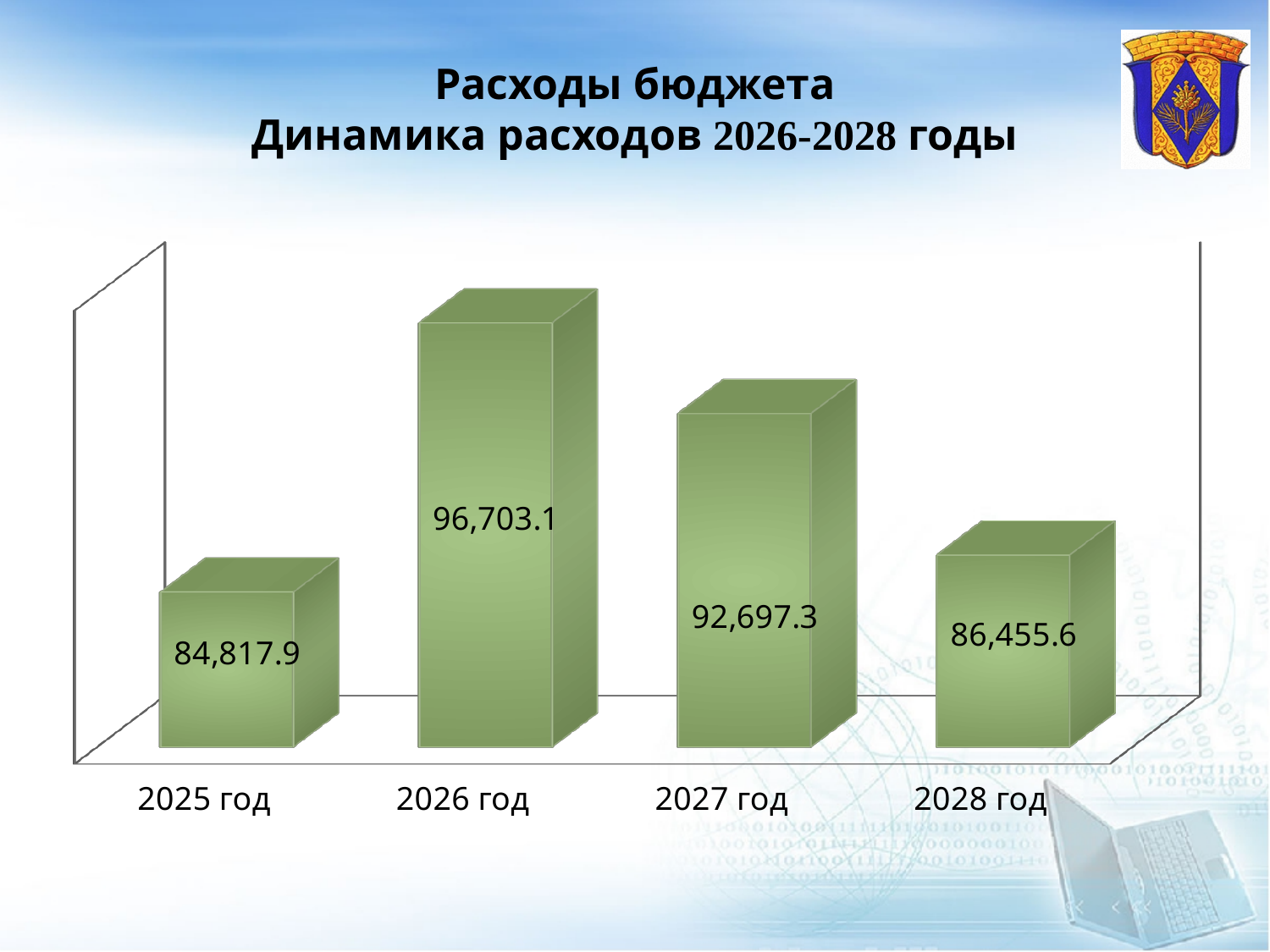
Which is larger, the value for 2027 год or the value for 2028 год? 2027 год What is the value shown for 2026 год? 96,703.1 Which year has the lowest value? 2025 год What is the value shown for 2027 год? 92,697.3 What is the value shown for 2028 год? 86,455.6 What is the difference between the values for 2026 год and 2025 год? 11,885.2 From 2026 год to 2028 год, do the values rise or fall? Fall Which year has the highest value? 2026 год What kind of chart is shown on the slide? Bar chart How many years are shown on the chart? 4 What is the difference between the values for 2027 год and 2028 год? 6,241.7 What is the value shown for 2025 год? 84,817.9